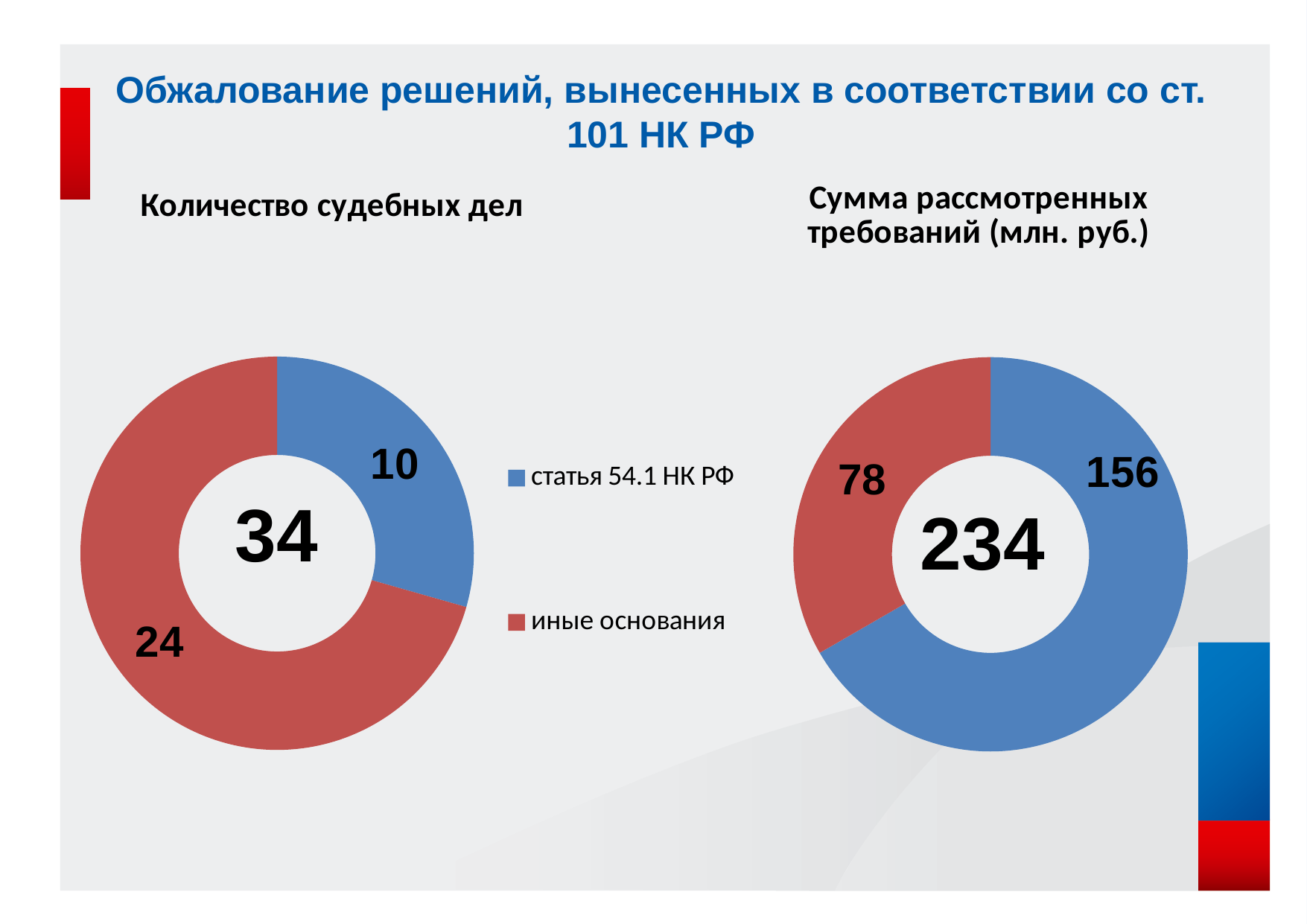
In the chart titled "Сумма рассмотренных требований (млн. руб.)", what is the difference between the values for "статья 54.1 НК РФ" and "иные основания"? 78 In the chart titled "Сумма рассмотренных требований (млн. руб.)", which is larger: "статья 54.1 НК РФ" or "иные основания"? статья 54.1 НК РФ In the chart titled "Количество судебных дел", which category has the largest value? иные основания In the chart titled "Сумма рассмотренных требований (млн. руб.)", what is the value for "статья 54.1 НК РФ"? 156 How many entries does the legend between the two charts list? 2 What total is shown in the centre of the chart titled "Количество судебных дел"? 34 In the chart titled "Сумма рассмотренных требований (млн. руб.)", what is the value for "иные основания"? 78 In the chart titled "Количество судебных дел", what is the value for "иные основания"? 24 In the chart titled "Количество судебных дел", what is the value for "статья 54.1 НК РФ"? 10 What type of chart is used on the left of the slide, titled "Количество судебных дел"? Donut (pie) chart In the chart titled "Сумма рассмотренных требований (млн. руб.)", which category has the smallest value? иные основания In the chart titled "Количество судебных дел", what is the difference between the values for "иные основания" and "статья 54.1 НК РФ"? 14